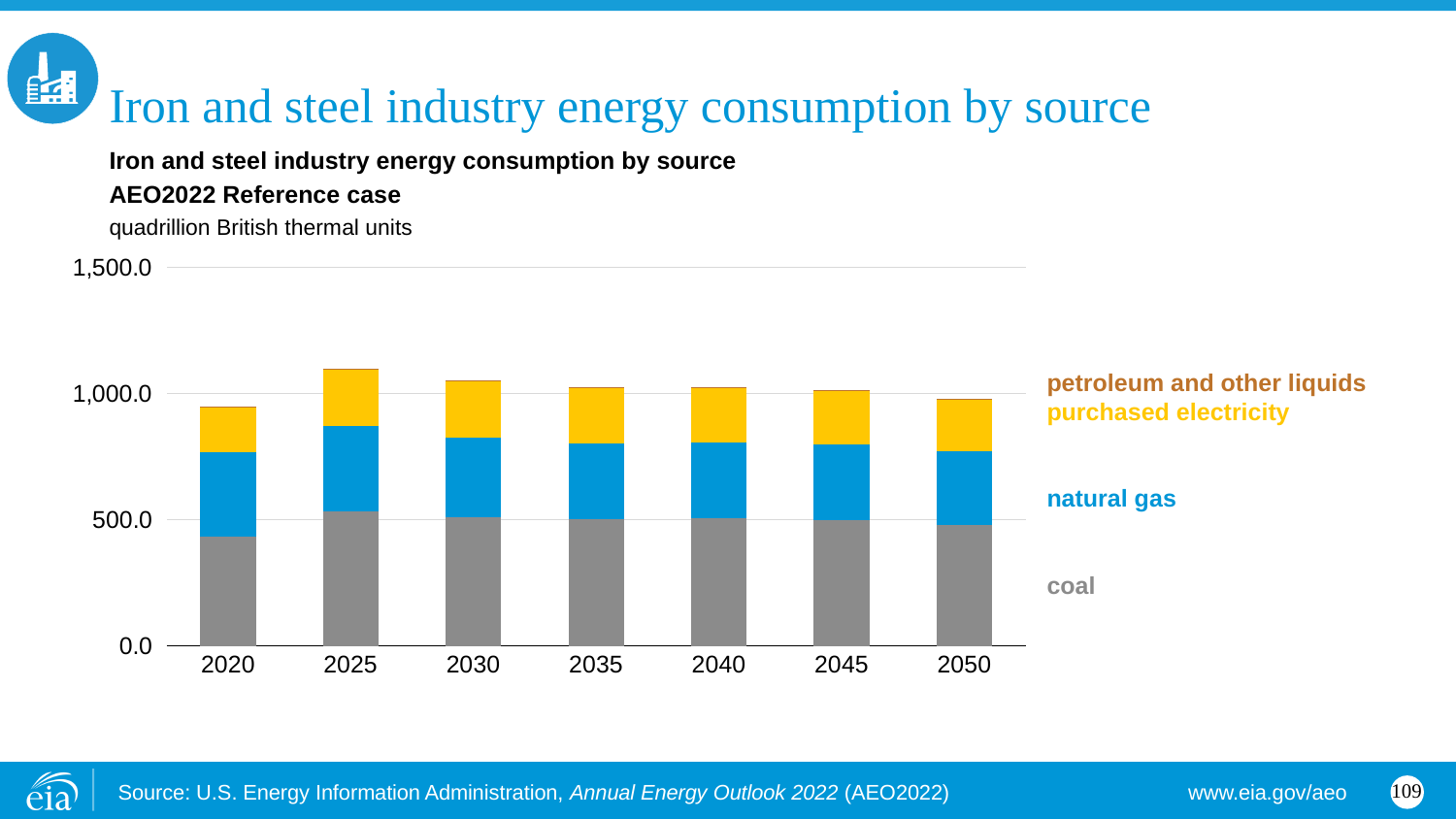
Which energy source is shown in gray at the bottom of each bar? coal Is the coal consumption for 2020 greater or less than 500.0? less Is the total energy consumption for 2020 greater or less than 1,000.0? less Is the total energy consumption for 2025 greater or less than 1,000.0? greater How many energy sources does the chart's legend list? 4 Which year has the highest total iron and steel industry energy consumption? 2025 What kind of chart is shown on the slide? stacked bar chart From 2025 to 2050, does the total energy consumption rise or fall? fall How many years are shown on the x axis of the chart? 7 Which year has the larger total energy consumption, 2020 or 2025? 2025 What unit is the chart measured in? quadrillion British thermal units